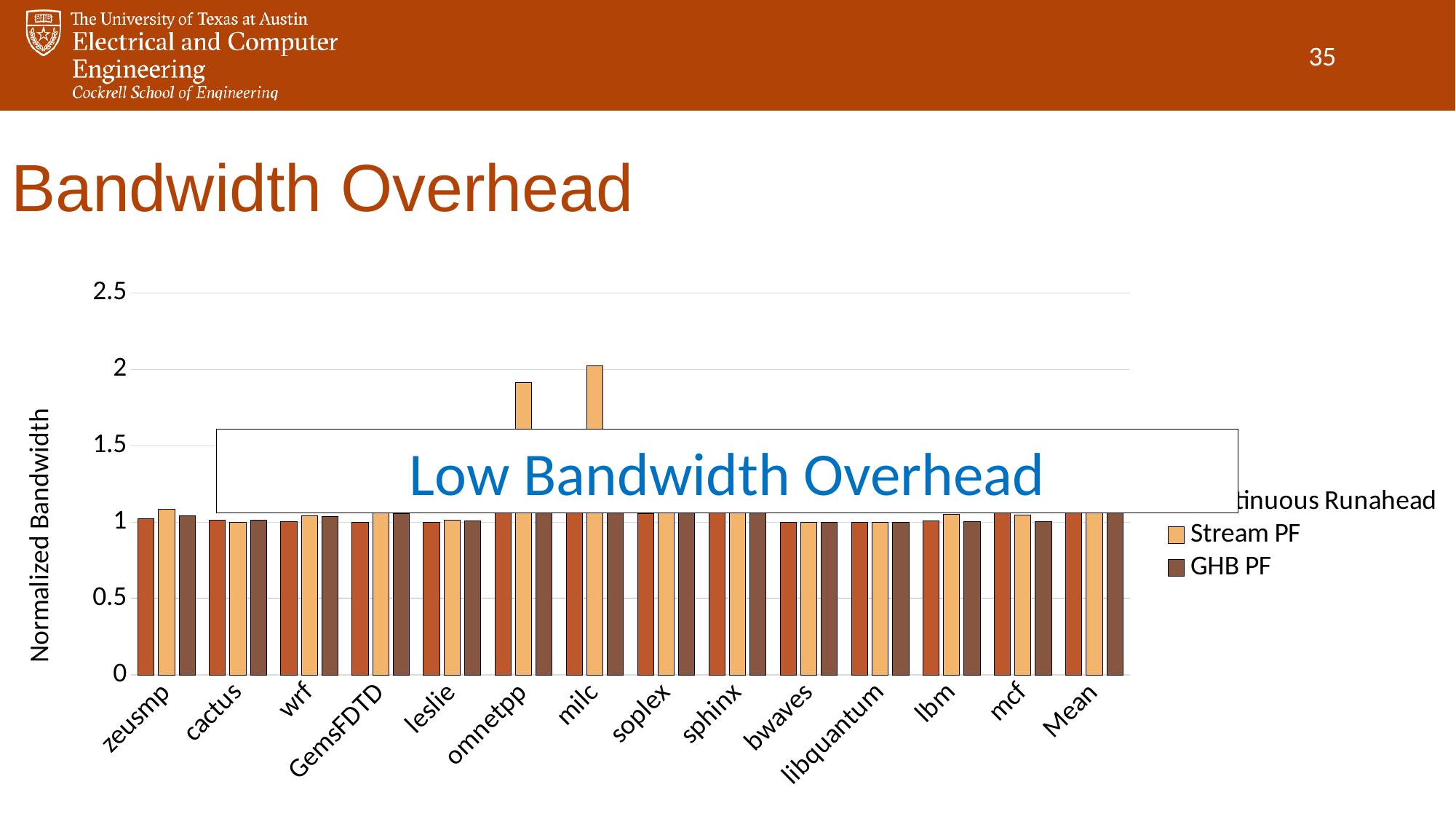
Is the GHB PF value for zeusmp greater or less than 0.5? greater How many benchmark categories are shown along the x axis of the chart? 14 Which is larger for milc, the Stream PF value or the GHB PF value? Stream PF Which is larger, the Stream PF value for omnetpp or the Stream PF value for milc? milc How many series does the chart's legend list? 3 Is the Stream PF value for omnetpp greater or less than 1.5? greater What is the label of the vertical axis of the chart? Normalized Bandwidth What is the last category shown on the x axis of the chart? Mean Is the Stream PF value for omnetpp greater or less than 2? less What kind of chart is shown on the slide? bar chart Which benchmark has the highest Stream PF value? milc